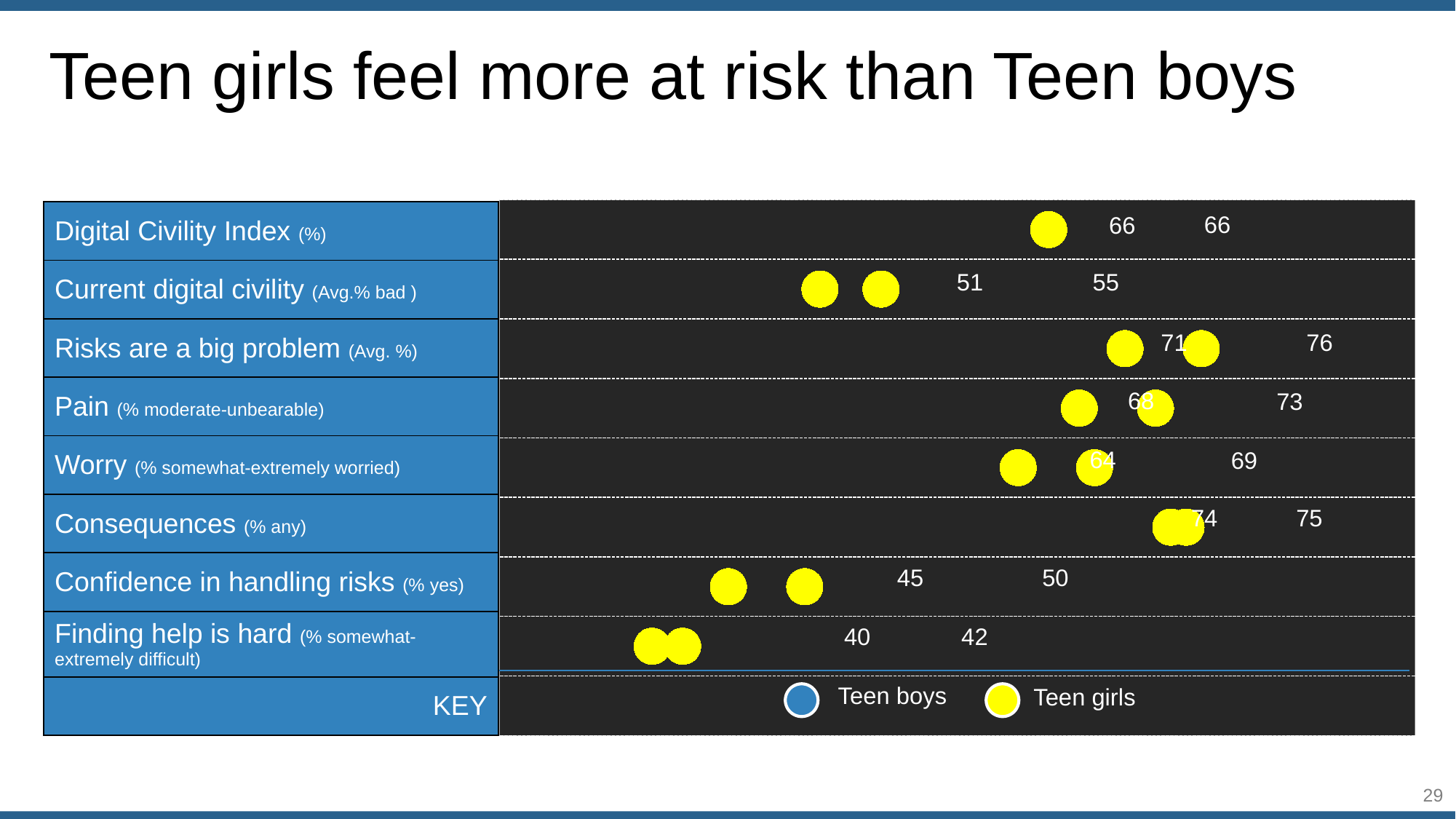
Which row has the highest printed value in the chart? Risks are a big problem What is the higher of the two values printed for Risks are a big problem? 76 Which row has the lowest printed value in the chart? Finding help is hard What is the lower of the two values printed for Current digital civility? 51 What is the difference between the two values printed for Worry? 5 What is the difference between the two values printed for Risks are a big problem? 5 How many series does the key list? 2 What two values are printed for the Finding help is hard row? 40 and 42 What two values are printed for the Confidence in handling risks row? 45 and 50 Which row shows the same value for both series? Digital Civility Index How many measure rows (categories) are plotted in the chart? 8 What are the two series named in the key? Teen boys and Teen girls